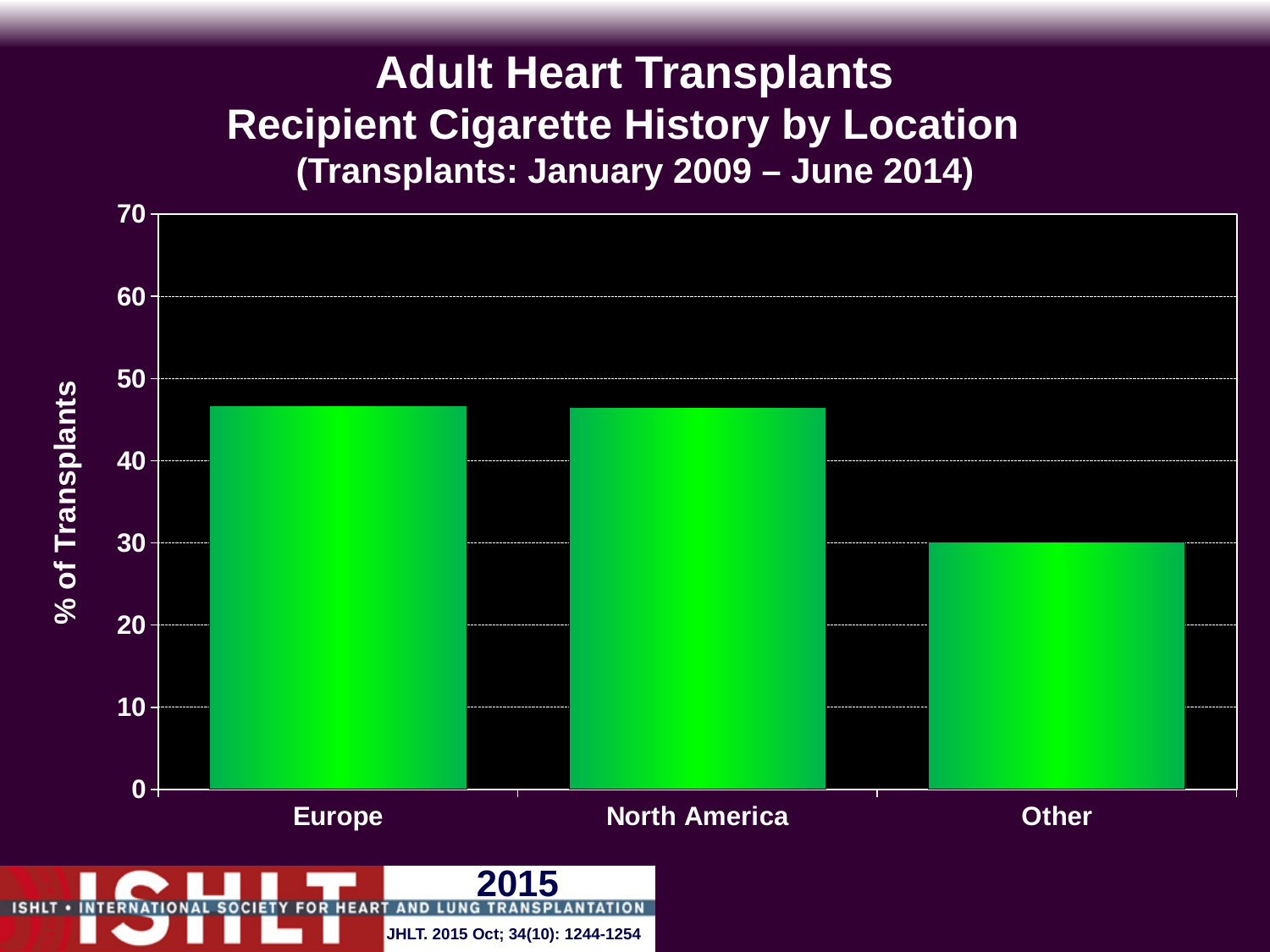
Is the value for Europe greater or less than 50? less Is the value for North America greater or less than 50? less Is the value for Other greater or less than 20? greater What kind of chart is shown on the slide? bar chart What is the label on the vertical axis of the chart? % of Transplants How many location categories are plotted on the chart? 3 Which is larger, the value for Europe or the value for Other? Europe What time period of transplants does the chart title say it covers? January 2009 – June 2014 Which location has the lowest % of transplants? Other